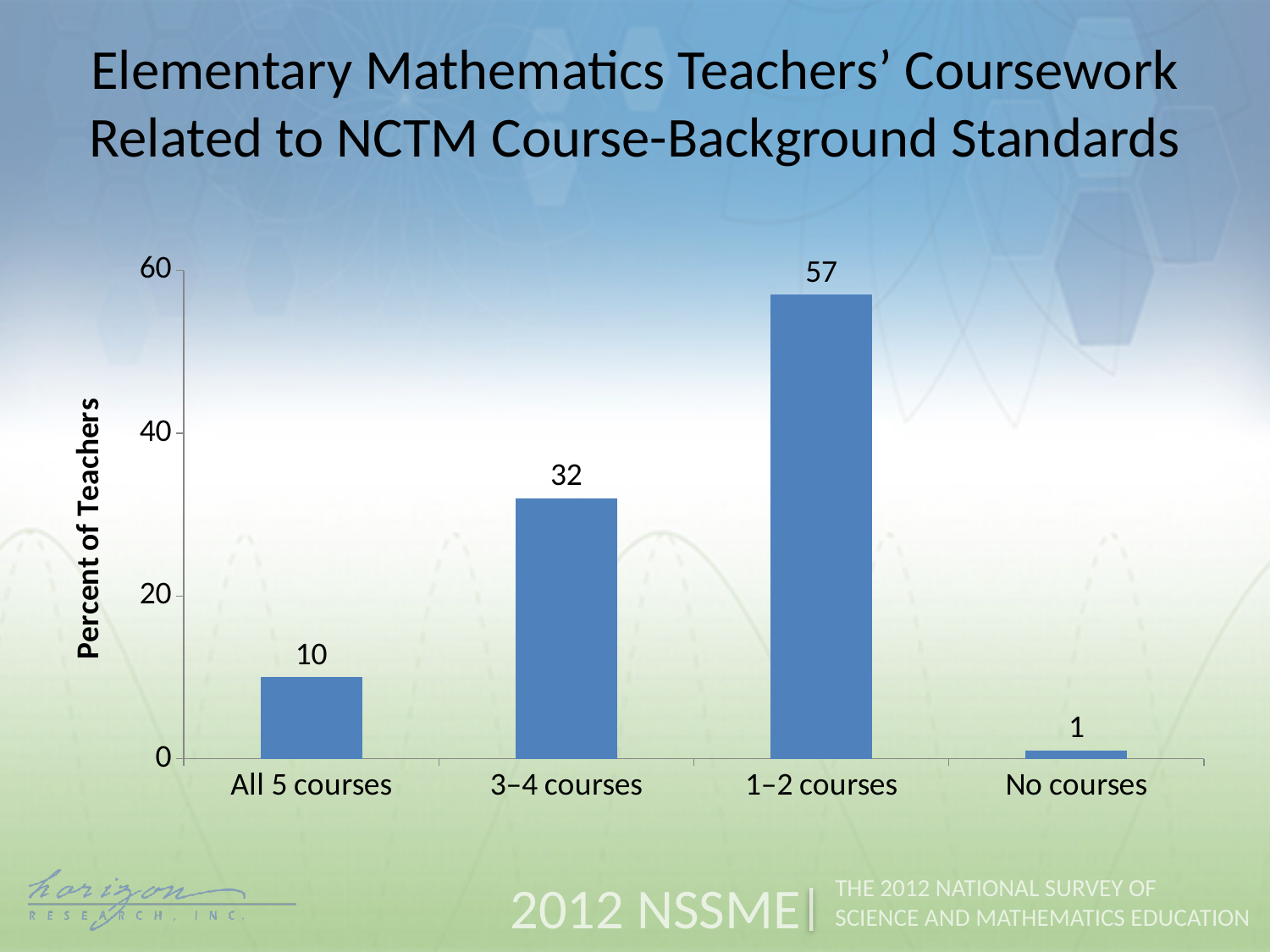
Is the value for 1–2 courses greater or less than 40? greater How many categories are shown on the x axis? 4 What percent of teachers took all 5 courses? 10 Which category has the lowest percent of teachers? No courses What is the value for 1–2 courses? 57 What kind of chart is shown on the slide? bar chart What is the difference between the values for 1–2 courses and 3–4 courses? 25 What is the label of the y axis? Percent of Teachers What is the value for 3–4 courses? 32 Which category has the highest percent of teachers? 1–2 courses What is the value for No courses? 1 Which is larger, the value for All 5 courses or the value for 3–4 courses? 3–4 courses